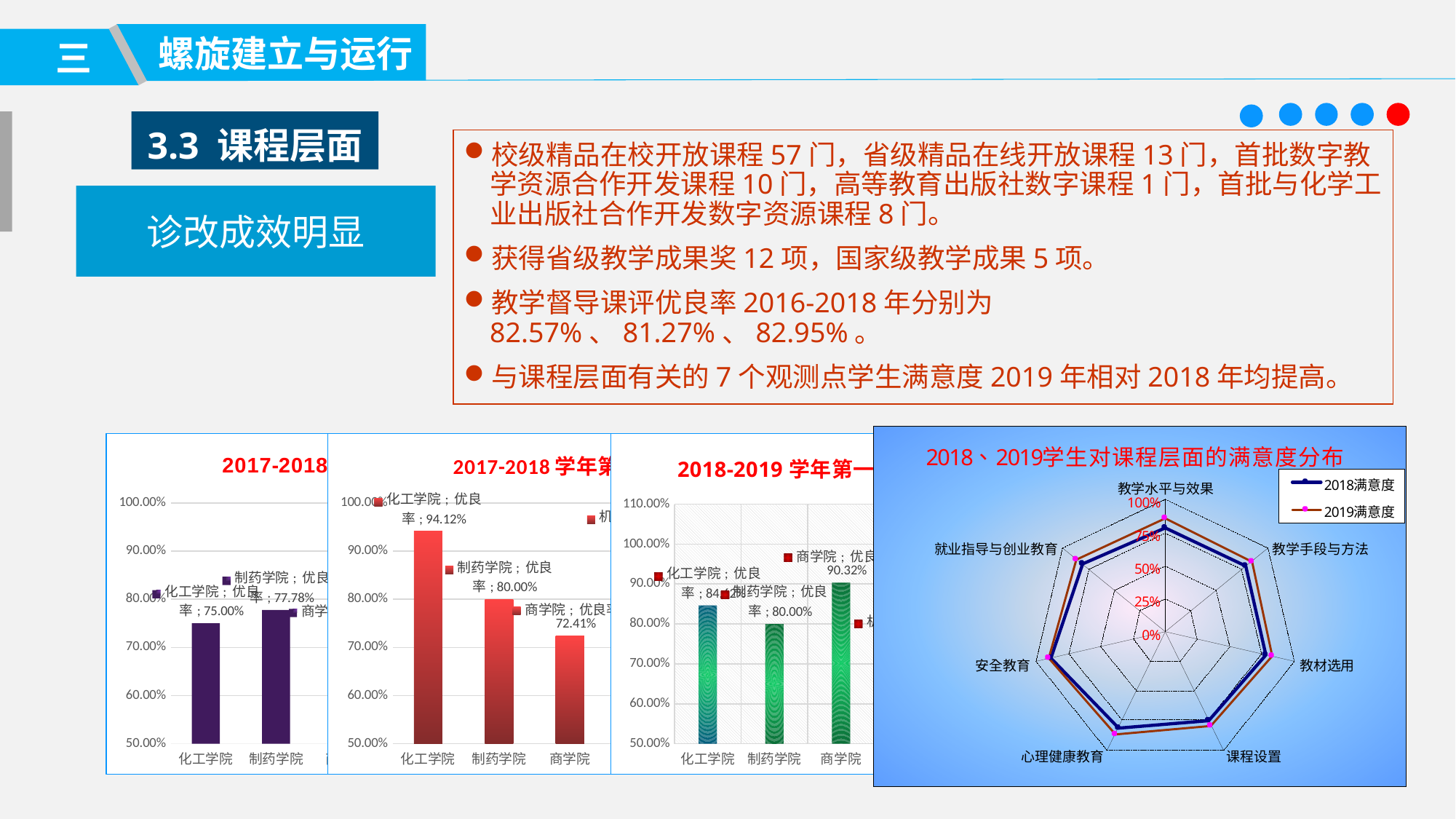
In the third bar chart from the left (green bars), what is the value for 商学院? 90.32% In the second bar chart from the left (red bars), what is the value for 商学院? 72.41% In the second bar chart from the left (red bars), what is the value for 化工学院? 94.12% In the second bar chart from the left (red bars), what is the difference between the values for 化工学院 and 制药学院? 14.12% In the second bar chart from the left (red bars), which category has the highest value? 化工学院 In the leftmost bar chart (purple bars), which is larger, the value for 化工学院 or 制药学院? 制药学院 In the third bar chart from the left (green bars), what is the value for 制药学院? 80.00% In the radar chart on the right, how many series does the legend list? 2 In the radar chart on the right, how many categories (axes) are plotted? 7 In the leftmost bar chart (purple bars), what is the value for 化工学院? 75.00%